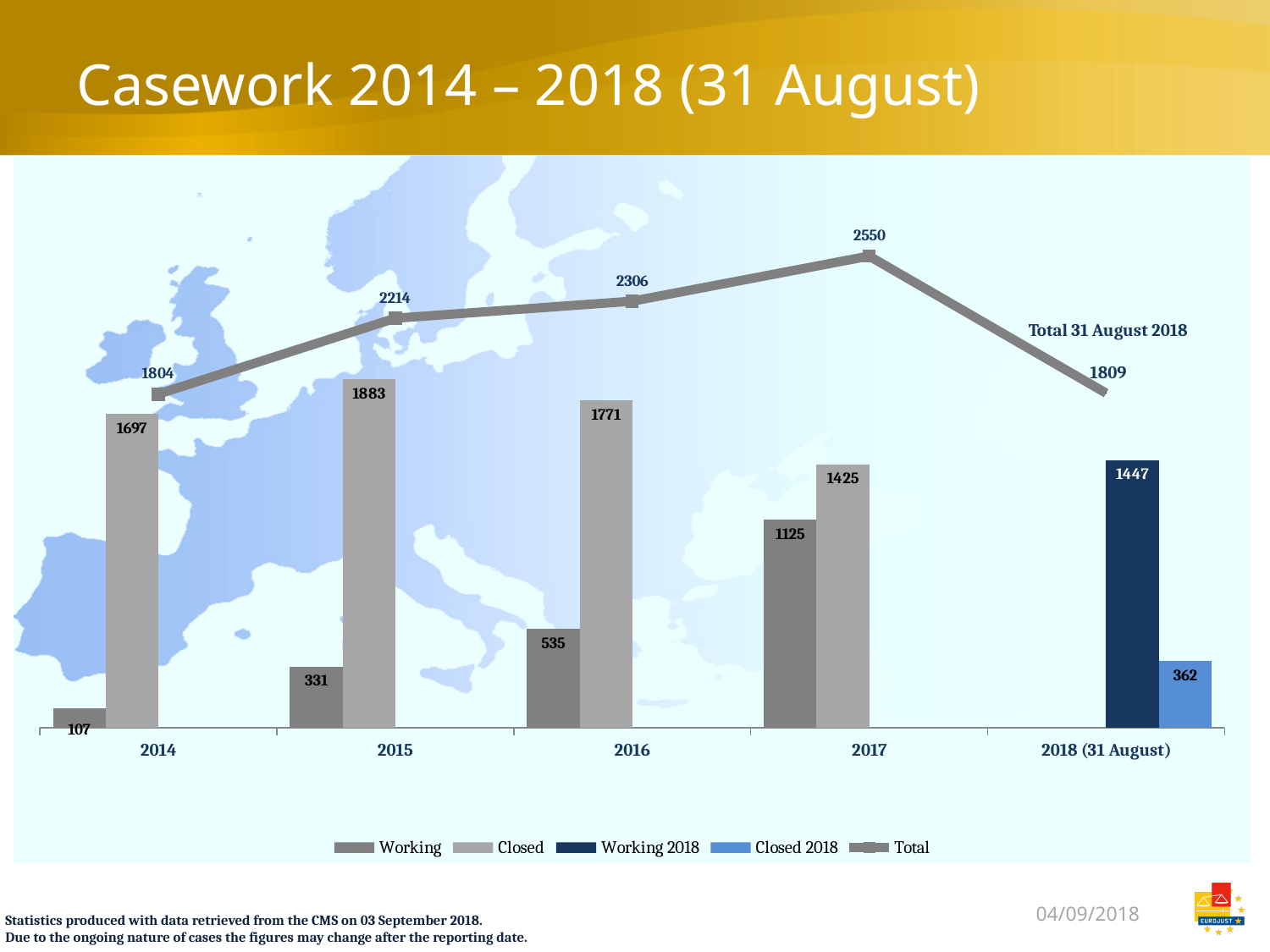
What kind of chart is this? Combined bar and line chart How many series does the legend list? 5 What is the difference between the Closed and Working values in 2016? 1236 Which year has the highest Total value? 2017 What is the Closed value for 2015? 1883 How many year categories are shown on the x axis? 5 Which is larger in 2017, the Working value or the Closed value? Closed What is the Working 2018 value for 2018 (31 August)? 1447 Does the Total line rise or fall from 2014 to 2017? Rise What is the Total value for 2017? 2550 Which year has the lowest Working value among 2014 to 2017? 2014 What is the title of the slide? Casework 2014 – 2018 (31 August)